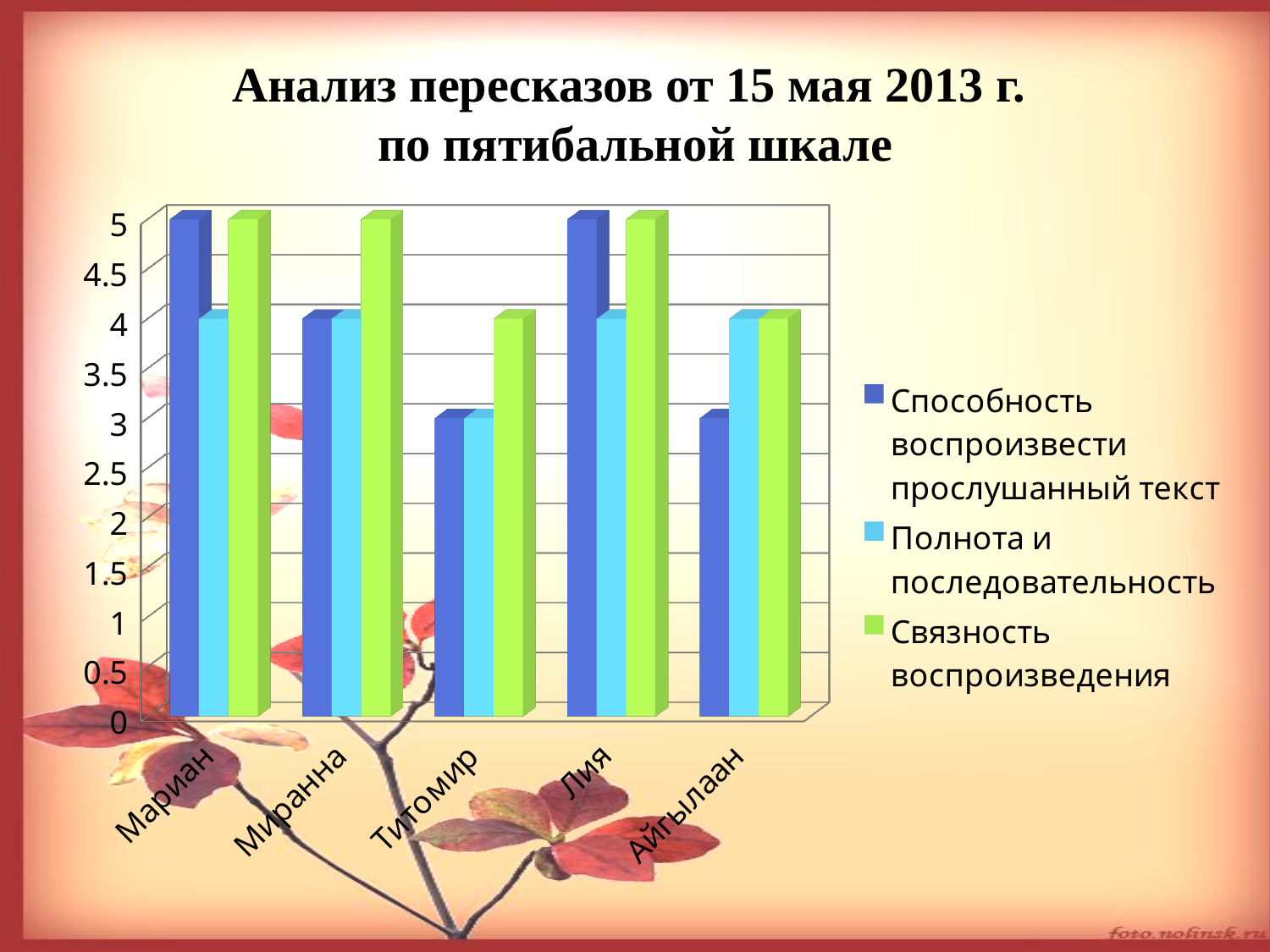
What is the value of "Связность воспроизведения" for Айгылаан? 4 How many series does the legend list? 3 Is the value of "Полнота и последовательность" for Титомир greater or less than 4? less Which is larger: the "Способность воспроизвести прослушанный текст" value for Лия or for Айгылаан? Лия Which student has the lowest value for "Связность воспроизведения"? Титомир and Айгылаан (tied at 4) What is the difference between the "Связность воспроизведения" value for Лия and for Титомир? 1 What is the value of "Способность воспроизвести прослушанный текст" for Титомир? 3 How many students (categories) are shown on the x axis? 5 What is the value of "Полнота и последовательность" for Мариан? 4 What is the title of the chart on the slide? Анализ пересказов от 15 мая 2013 г. по пятибальной шкале What type of chart is shown on the slide? Bar chart What is the value of "Связность воспроизведения" for Миранна? 5